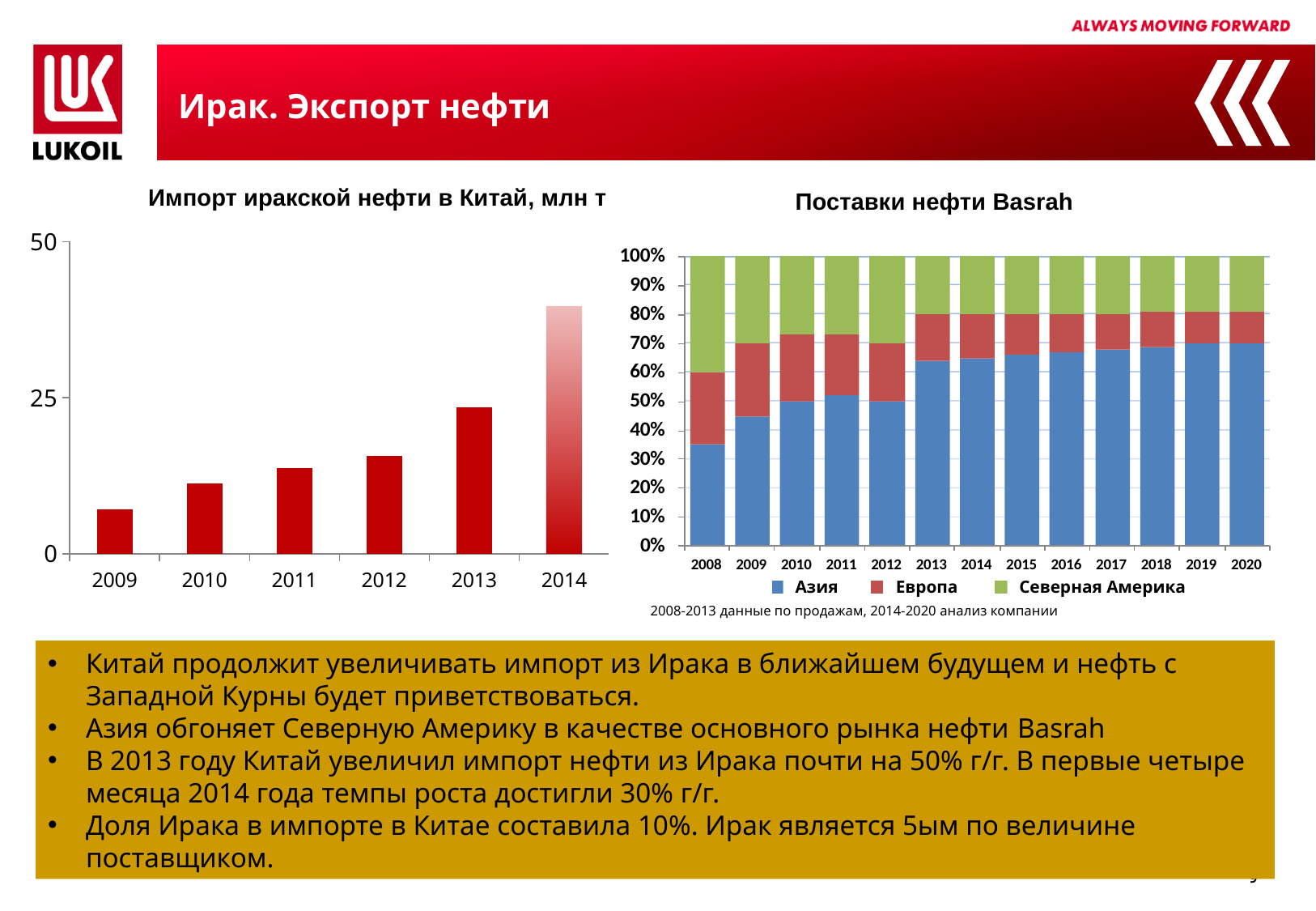
In the left chart "Импорт иракской нефти в Китай, млн т", which year has the highest bar? 2014 In the left chart "Импорт иракской нефти в Китай, млн т", is the value for 2012 greater or less than 25? less What kind of chart is the right chart titled "Поставки нефти Basrah"? stacked bar chart In the left chart "Импорт иракской нефти в Китай, млн т", which year has the larger value, 2012 or 2013? 2013 In the right chart "Поставки нефти Basrah", how many series does the legend list? 3 In the left chart "Импорт иракской нефти в Китай, млн т", is the value for 2014 greater or less than 25? greater What kind of chart is the left chart titled "Импорт иракской нефти в Китай, млн т"? bar chart In the left chart "Импорт иракской нефти в Китай, млн т", which year has the lowest bar? 2009 In the right chart "Поставки нефти Basrah", how many years are shown on the x axis? 13 In the left chart "Импорт иракской нефти в Китай, млн т", do the values rise or fall from 2009 to 2014? rise In the right chart "Поставки нефти Basrah", is the share of Азия in 2008 greater or less than 40%? less In the left chart "Импорт иракской нефти в Китай, млн т", how many years are shown on the x axis? 6